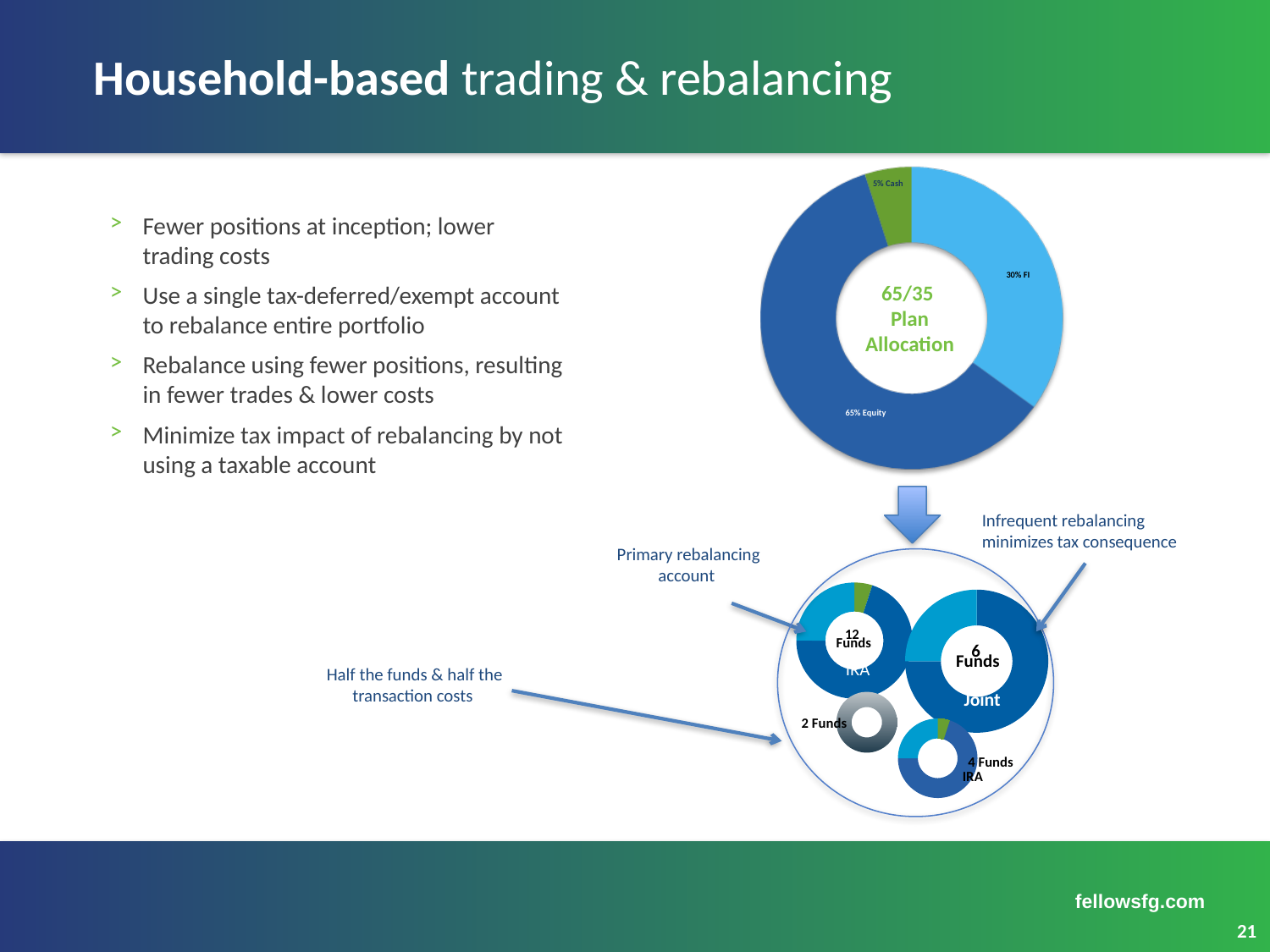
In the 65/35 Plan Allocation chart, what is the combined share of Equity and FI? 95% In the 65/35 Plan Allocation chart, what is the difference between the FI share and the Cash share? 25% In the 65/35 Plan Allocation chart, what share is allocated to FI? 30% In the 65/35 Plan Allocation chart, which is larger, the FI share or the Cash share? FI In the 65/35 Plan Allocation chart, what is the difference between the Equity share and the FI share? 35% How many categories are shown in the 65/35 Plan Allocation chart? 3 In the 65/35 Plan Allocation chart, what share is allocated to Equity? 65% What kind of chart is the 65/35 Plan Allocation chart? Doughnut (pie) chart In the 65/35 Plan Allocation chart, which category has the smallest share? Cash In the 65/35 Plan Allocation chart, what share is allocated to Cash? 5% What text appears in the centre of the large doughnut chart? 65/35 Plan Allocation In the 65/35 Plan Allocation chart, which category has the largest share? Equity